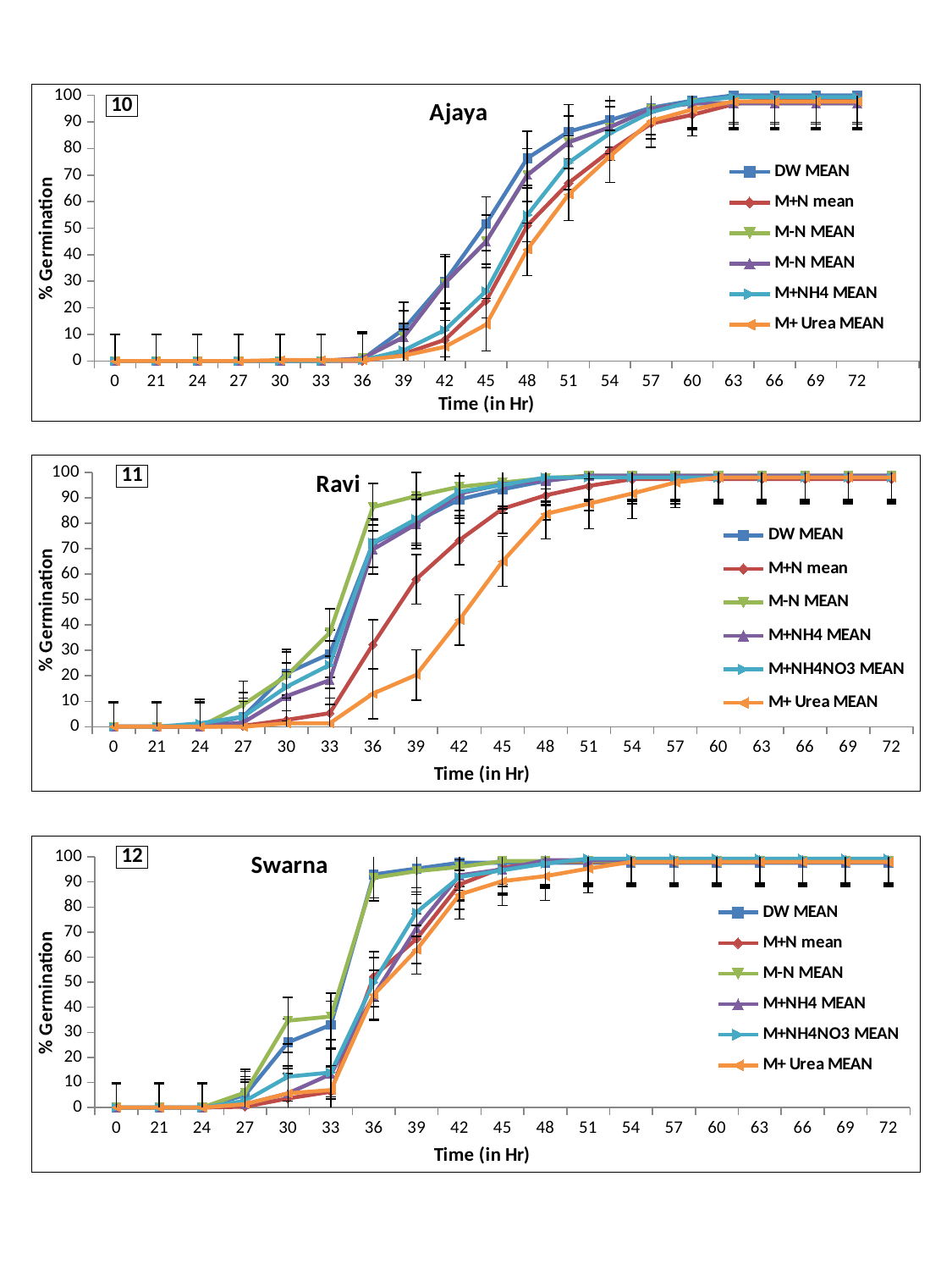
In the Ajaya chart (chart 10), at 48 hours, which is higher: DW MEAN or M+ Urea MEAN? DW MEAN In the Ajaya chart (chart 10), do the % Germination values rise or fall as time increases? Rise In the Ravi chart (chart 11), which series has the highest % Germination at 36 hours? M-N MEAN In the Swarna chart (chart 12), is the M+ Urea MEAN value at 33 hours greater or less than 20? less In the Ravi chart (chart 11), at 39 hours, which is higher: M-N MEAN or M+ Urea MEAN? M-N MEAN What kind of chart is the Ajaya chart (chart 10)? Line chart In the Ajaya chart (chart 10), is the DW MEAN value at 48 hours greater or less than 70? greater In the Ravi chart (chart 11), is the M-N MEAN value at 36 hours greater or less than 80? greater What is the label of the y axis on the Swarna chart (chart 12)? % Germination How many time points are marked on the x axis of the Swarna chart (chart 12)? 19 How many series does the legend of the Ravi chart (chart 11) list? 6